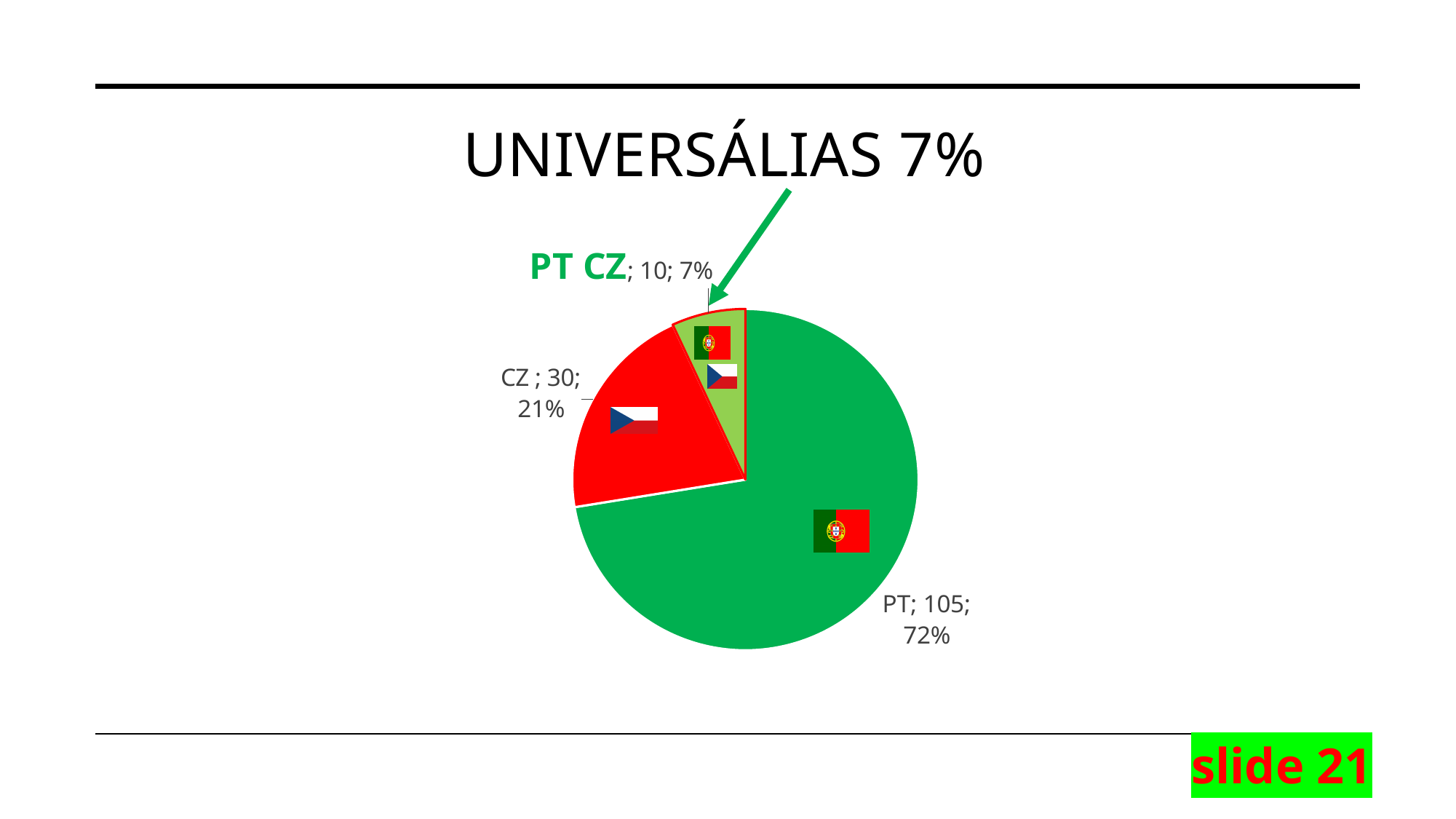
What is the value for CZ? 30 What share of the pie does CZ represent? 21% What is the title shown above the chart? UNIVERSÁLIAS 7% What is the difference between the values for PT and CZ? 75 What is the value for PT CZ? 10 What share of the pie does PT represent? 72% Which slice is the largest? PT Which slice is the smallest? PT CZ How many slices does the pie chart have? 3 What share of the pie does PT CZ represent? 7% What kind of chart is shown on the slide? pie chart What is the value for PT? 105